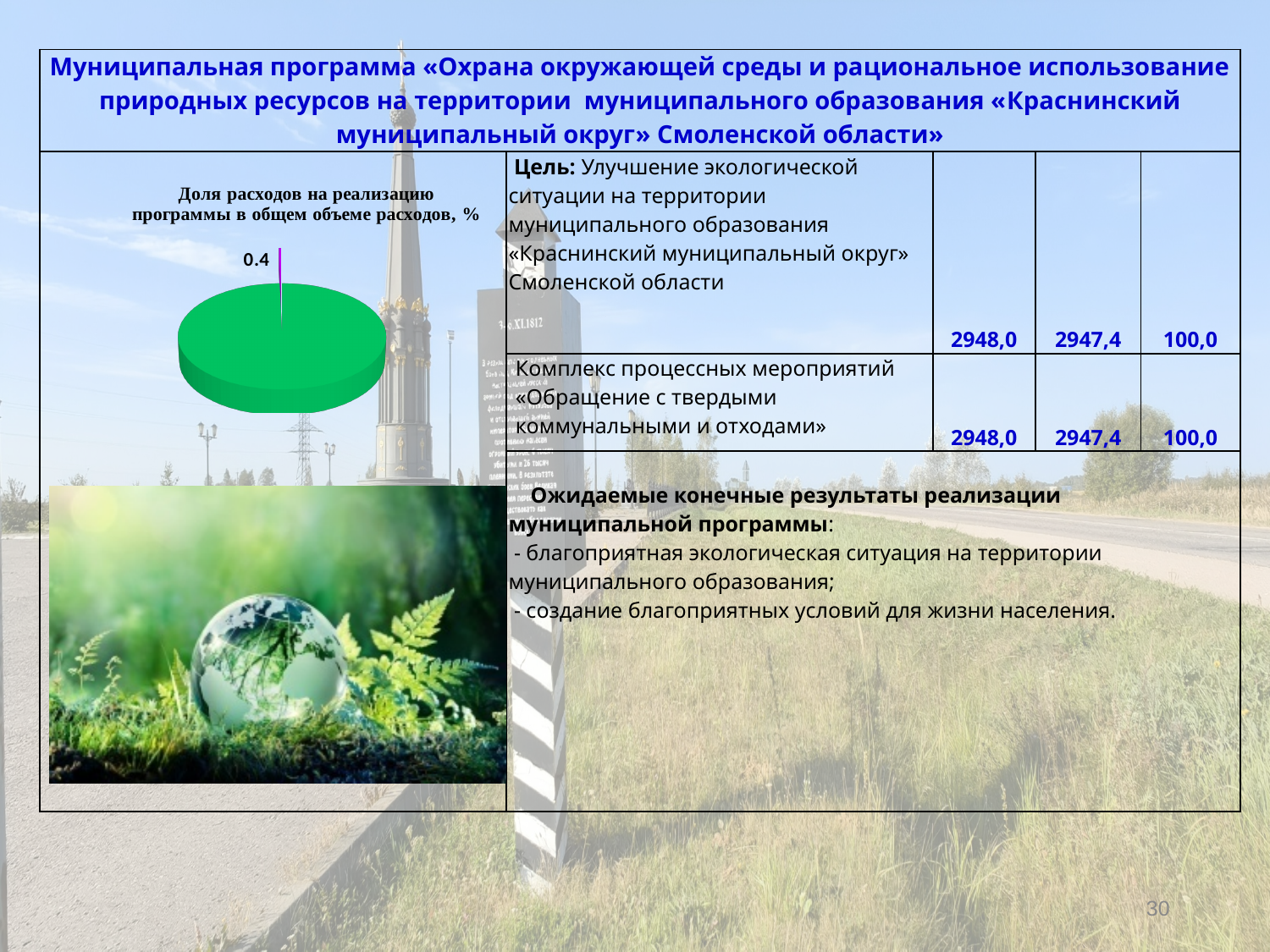
How many slices does the pie chart show? 2 Which slice of the pie chart is larger, the green slice or the purple slice? the green slice What is the title of the chart on the slide? Доля расходов на реализацию программы в общем объеме расходов, % Is the value labelled on the purple slice of the pie chart greater or less than 1? less What value is printed as the data label on the pie chart? 0.4 What kind of chart is shown on the slide? pie chart What colour is the largest slice of the pie chart? green